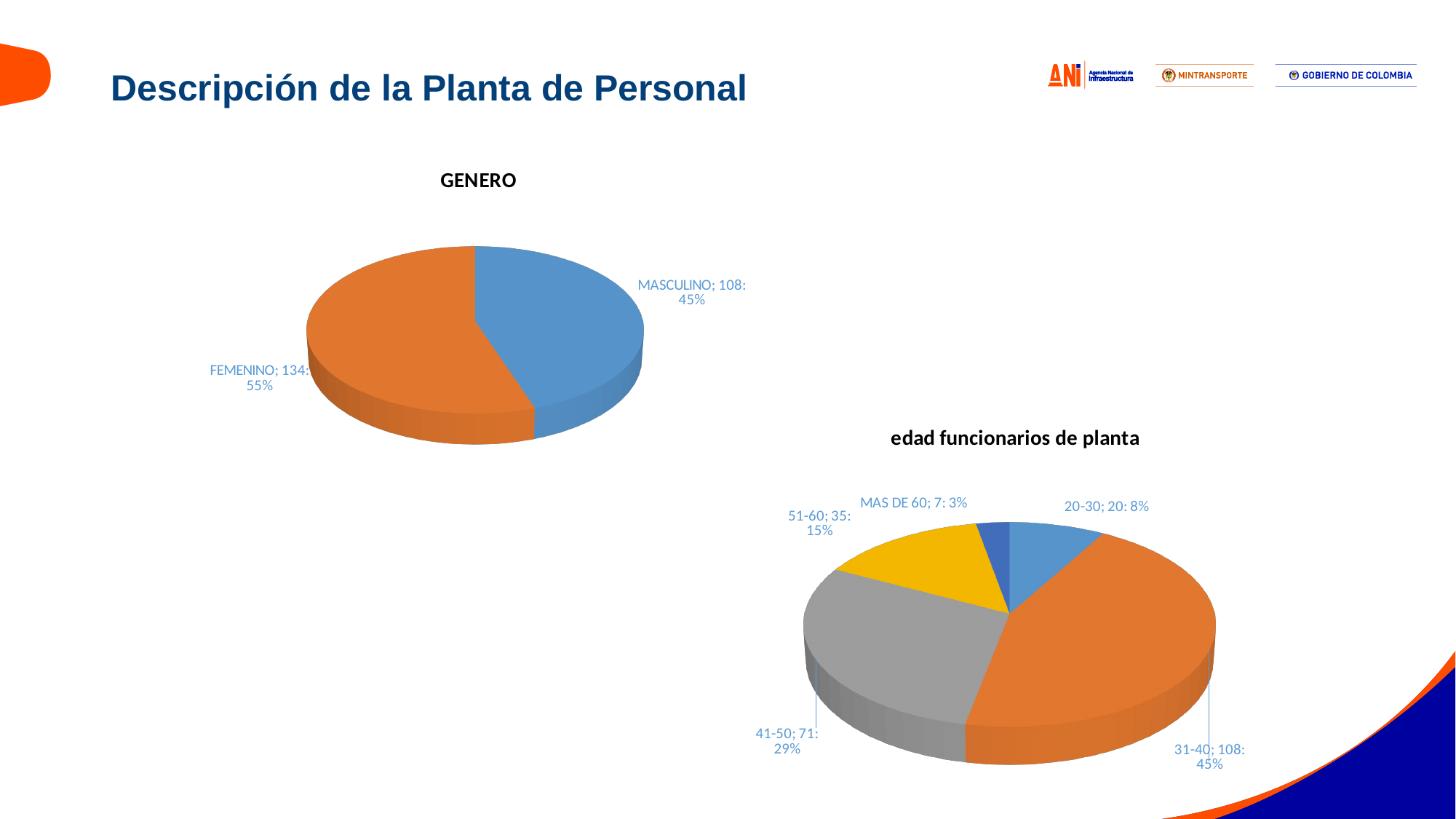
In the edad funcionarios de planta chart, what share of the pie is 51-60? 15% In the edad funcionarios de planta chart, which is larger, 20-30 or 51-60? 51-60 In the edad funcionarios de planta chart, what is the value for 41-50? 71 In the GENERO chart, how many slices does the pie have? 2 In the GENERO chart, what share of the pie is MASCULINO? 45% In the GENERO chart, what is the difference between FEMENINO and MASCULINO? 26 In the edad funcionarios de planta chart, what is the difference between 31-40 and 41-50? 37 What kind of chart is the GENERO chart? Pie chart In the GENERO chart, what is the value for FEMENINO? 134 In the edad funcionarios de planta chart, which age group is the largest? 31-40 In the edad funcionarios de planta chart, which age group is the smallest? MAS DE 60 In the edad funcionarios de planta chart, how many age groups are shown? 5